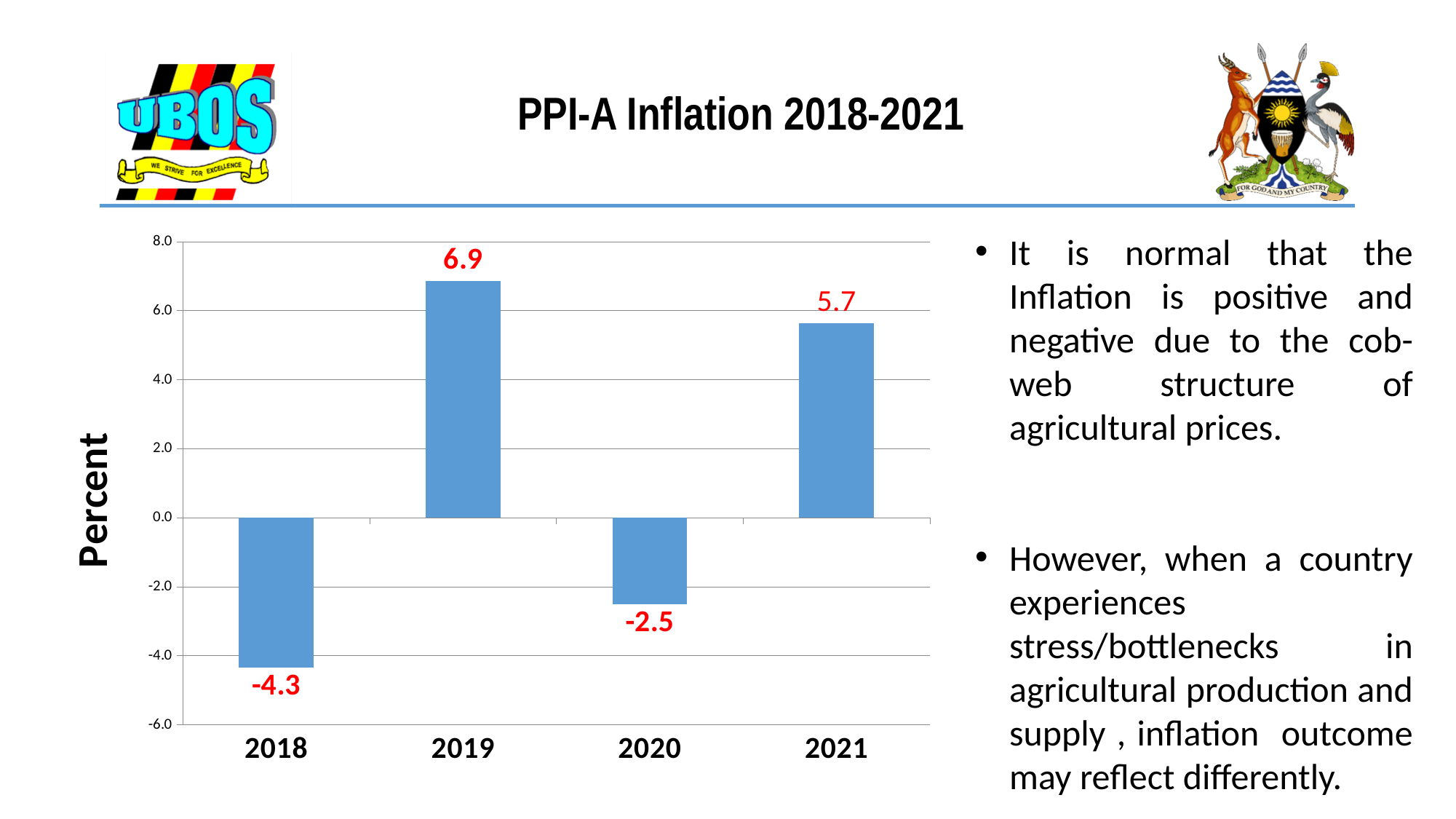
What kind of chart is shown on the slide? bar chart What is the PPI-A inflation value for 2020? -2.5 How many years are shown on the chart? 4 Which year has the highest PPI-A inflation? 2019 What is the PPI-A inflation value for 2021? 5.7 Which year has the larger value, 2018 or 2020? 2020 What is the label on the vertical axis of the chart? Percent Which year has the lowest PPI-A inflation? 2018 Is the value for 2021 greater or less than 4.0? greater What is the PPI-A inflation value for 2019? 6.9 What is the PPI-A inflation value for 2018? -4.3 What is the difference between the 2019 and 2021 values? 1.2